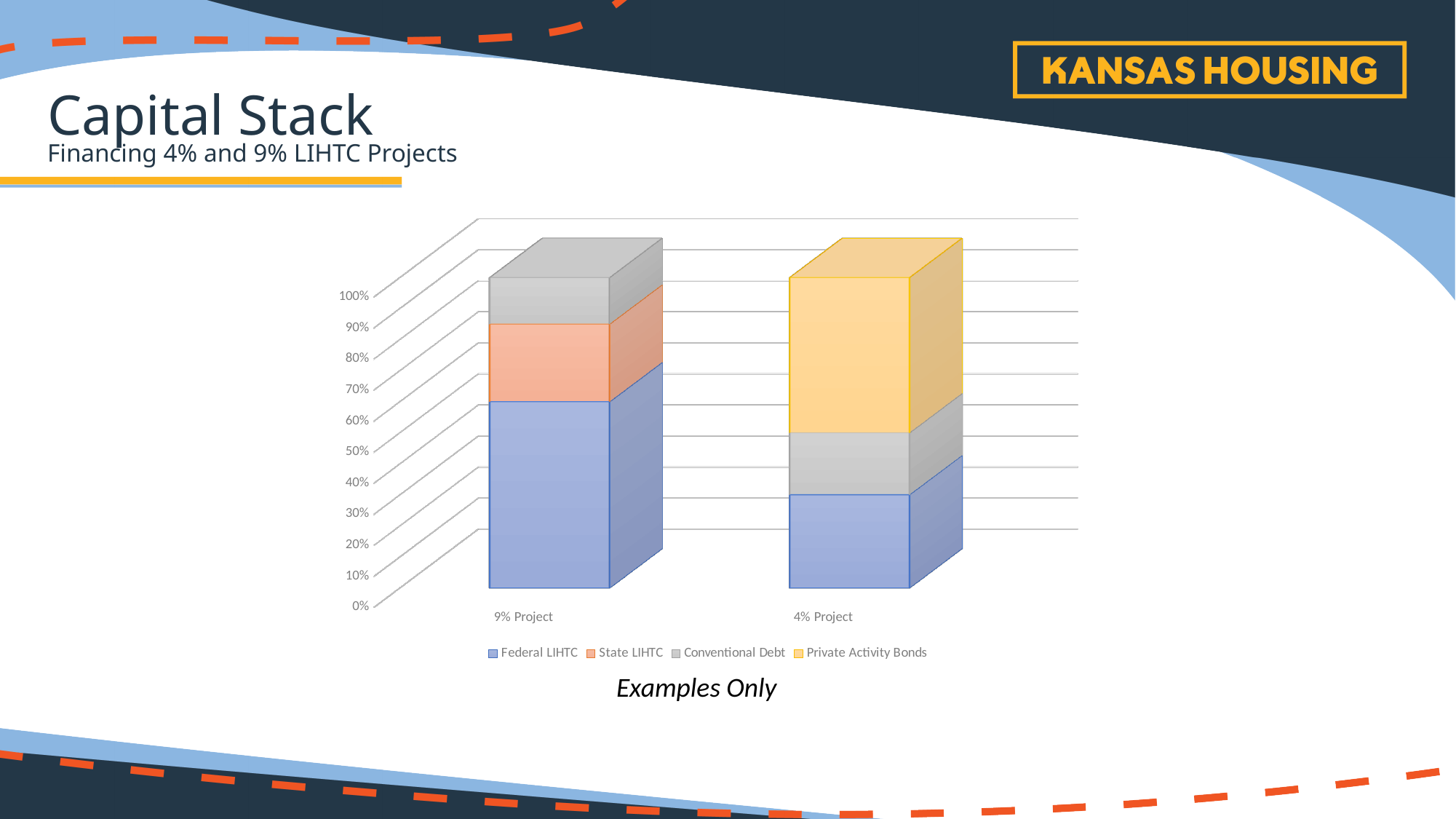
Which series make up the capital stack according to the legend? Federal LIHTC, State LIHTC, Conventional Debt, Private Activity Bonds Which project category includes a State LIHTC segment? 9% Project Is the Private Activity Bonds share for the 4% Project greater or less than 40%? greater Which series is the largest segment of the 4% Project bar? Private Activity Bonds How many series does the chart legend list? 4 How many project categories are shown on the x axis of the chart? 2 Is the Federal LIHTC share for the 9% Project greater or less than 50%? greater Which project category has the larger Federal LIHTC share, 9% Project or 4% Project? 9% Project What kind of chart is shown on the slide? Stacked bar chart Which project category includes a Private Activity Bonds segment? 4% Project Which series is the largest segment of the 9% Project bar? Federal LIHTC Is the Federal LIHTC share for the 4% Project greater or less than 40%? less